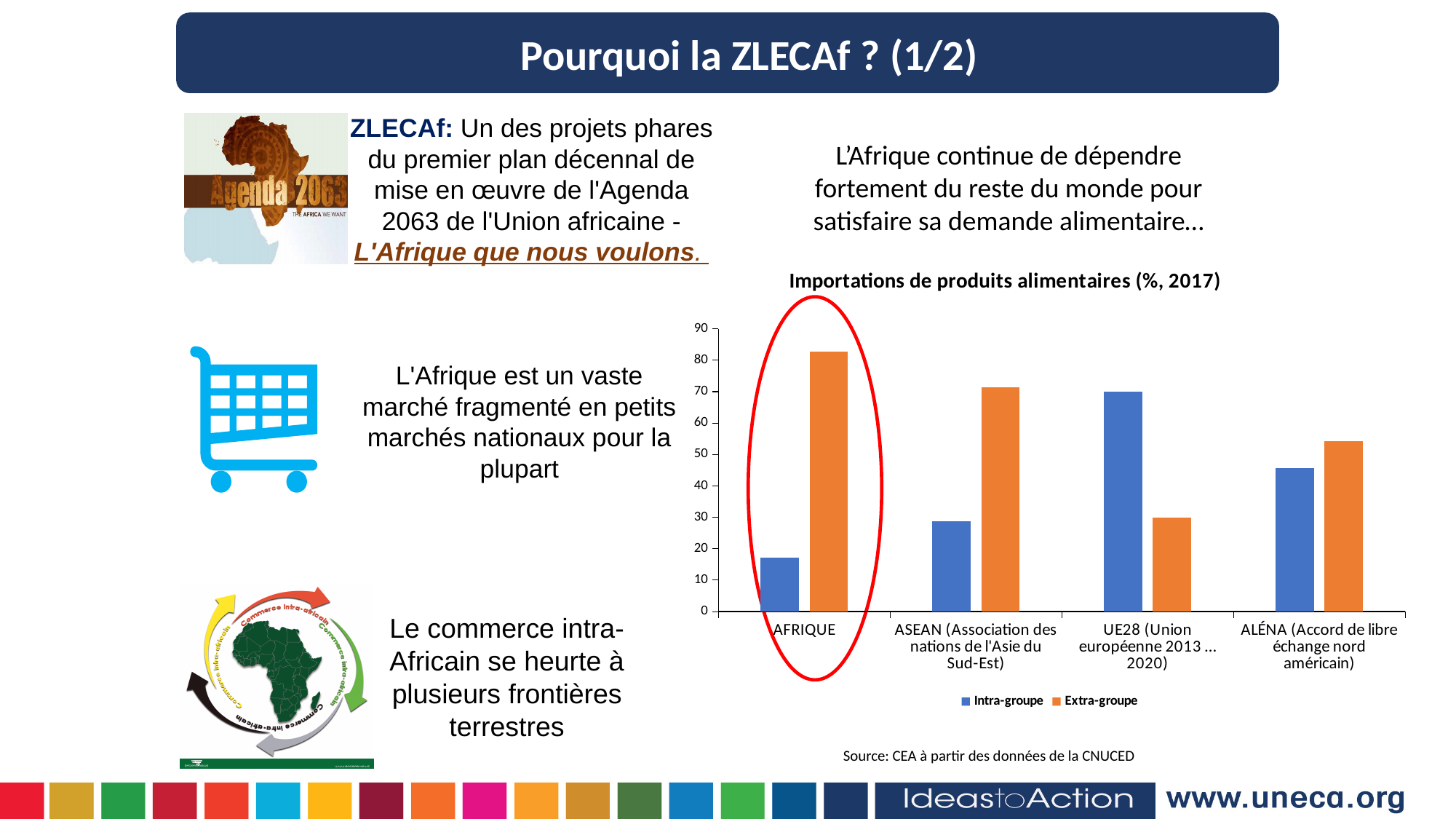
What are the two series named in the chart's legend? Intra-groupe and Extra-groupe Is the Intra-groupe value for UE28 greater or less than 60? greater How many categories are shown on the x axis of the chart? 4 What kind of chart is shown under the title 'Importations de produits alimentaires (%, 2017)'? bar chart Is the Extra-groupe value for AFRIQUE greater or less than 80? greater Is the Extra-groupe value for ASEAN greater or less than 60? greater How many series does the chart's legend list? 2 Which colour represents the Extra-groupe series in the chart? orange Which category has the highest Extra-groupe value? AFRIQUE For UE28, which is larger: the Intra-groupe value or the Extra-groupe value? Intra-groupe Which category has the lowest Intra-groupe value? AFRIQUE